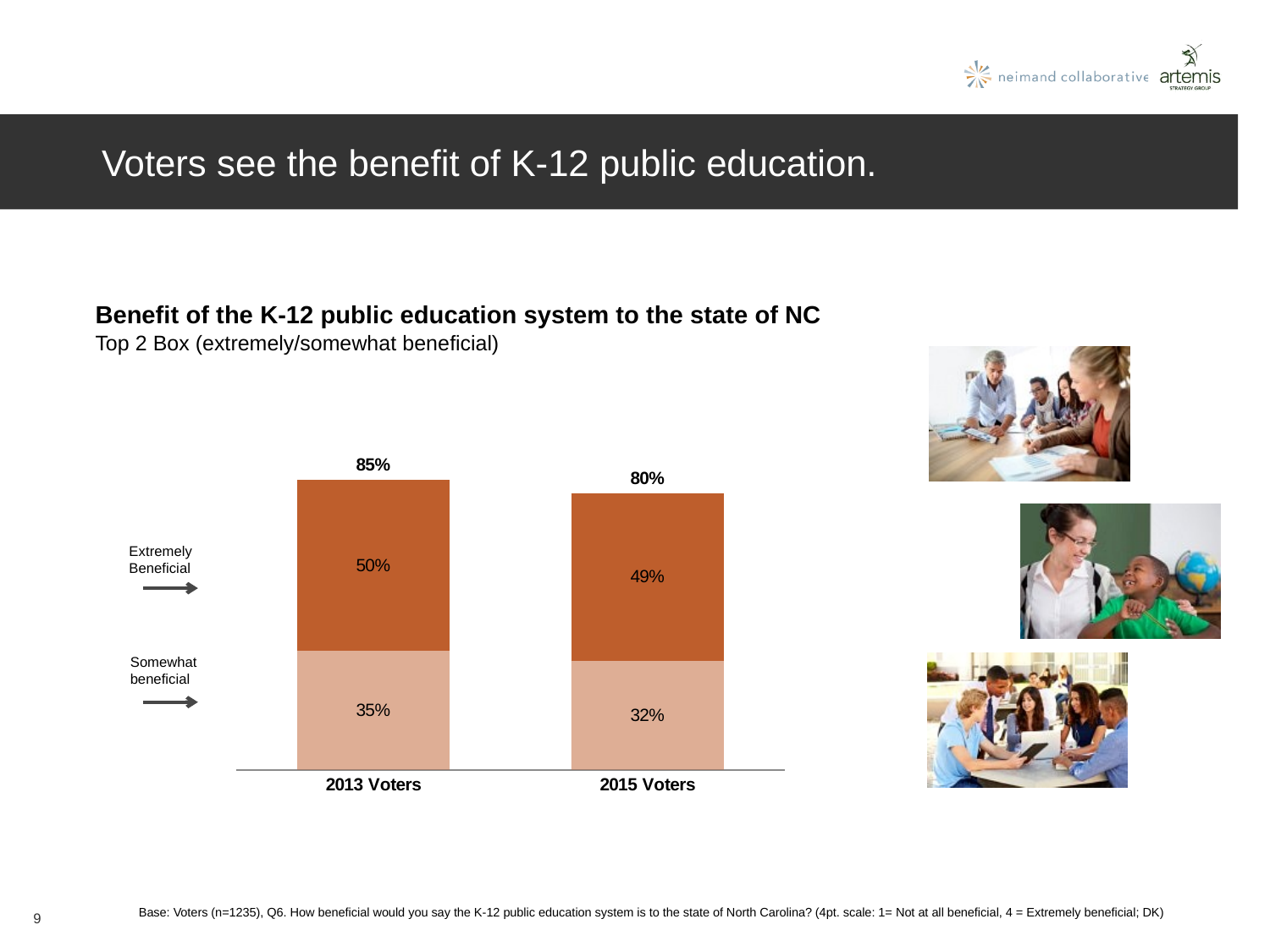
What percentage of 2015 Voters rated the K-12 public education system as Somewhat beneficial? 32% Does the Top 2 Box total rise or fall from 2013 Voters to 2015 Voters? Fall Which segment is larger for 2015 Voters, Extremely Beneficial or Somewhat beneficial? Extremely Beneficial What is the title of the chart? Benefit of the K-12 public education system to the state of NC What is the difference between the Somewhat beneficial values for 2013 Voters and 2015 Voters? 3% What is the difference between the Top 2 Box totals for 2013 Voters and 2015 Voters? 5% What percentage of 2013 Voters rated the K-12 public education system as Extremely Beneficial? 50% Which group has the higher Top 2 Box total, 2013 Voters or 2015 Voters? 2013 Voters How many voter groups are shown on the x axis of the chart? 2 What is the Top 2 Box total shown above the bar for 2015 Voters? 80% What is the Top 2 Box total shown above the bar for 2013 Voters? 85% What kind of chart is used to show the benefit of the K-12 public education system? Stacked bar chart